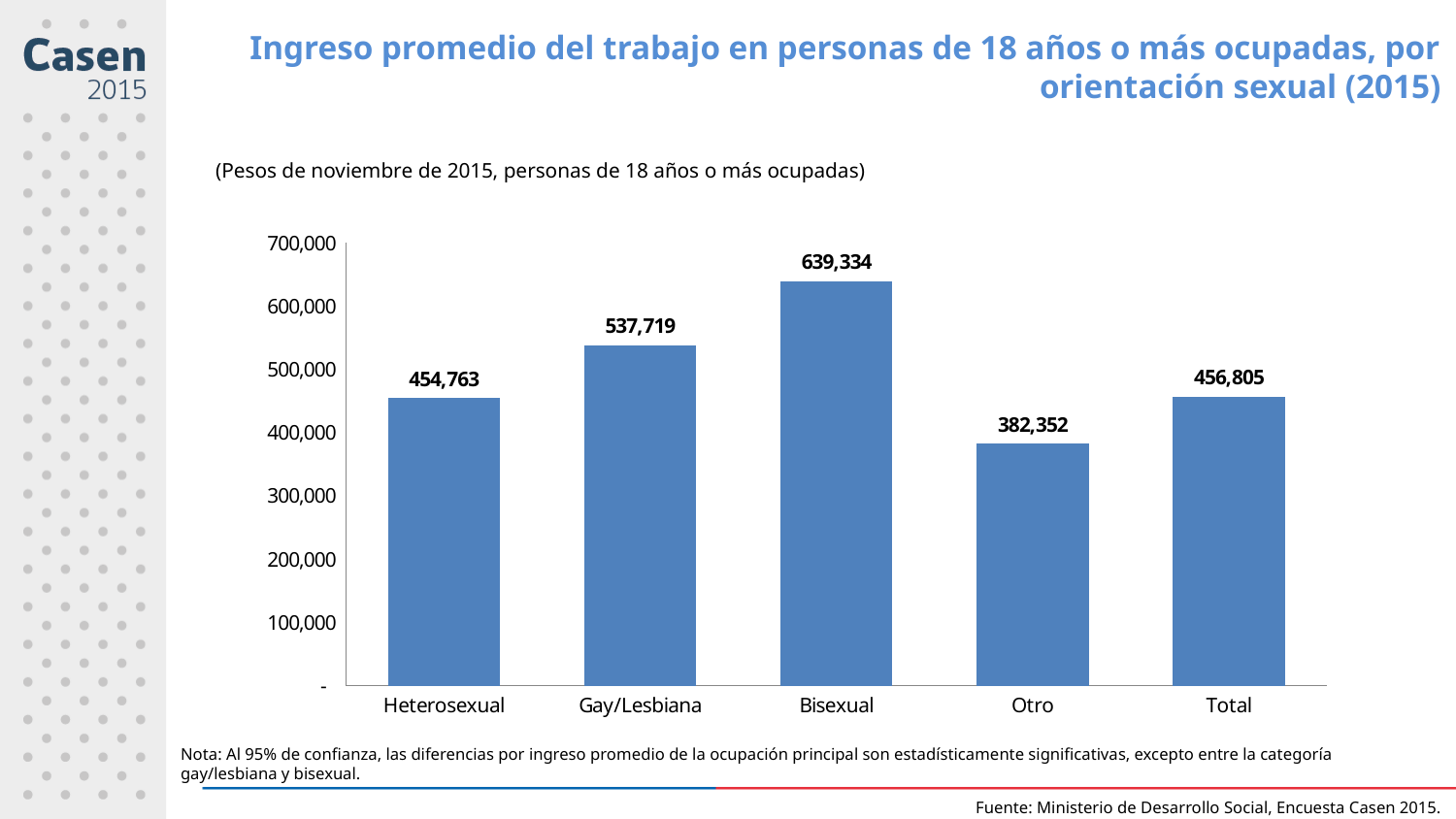
What kind of chart is shown on the slide? bar chart What is the value shown for the Otro category? 382,352 What is the difference between the values for Bisexual and Otro? 256,982 Which is larger, the value for Gay/Lesbiana or the value for Bisexual? Bisexual Which category has the highest average labor income? Bisexual What is the difference between the values for Gay/Lesbiana and Heterosexual? 82,956 Which category has the lowest average labor income? Otro Is the value for Otro greater or less than 400,000? less What is the average labor income for Bisexual persons? 639,334 What is the value shown for the Total bar? 456,805 How many categories are shown on the x axis? 5 What is the title of the chart on the slide? Ingreso promedio del trabajo en personas de 18 años o más ocupadas, por orientación sexual (2015)